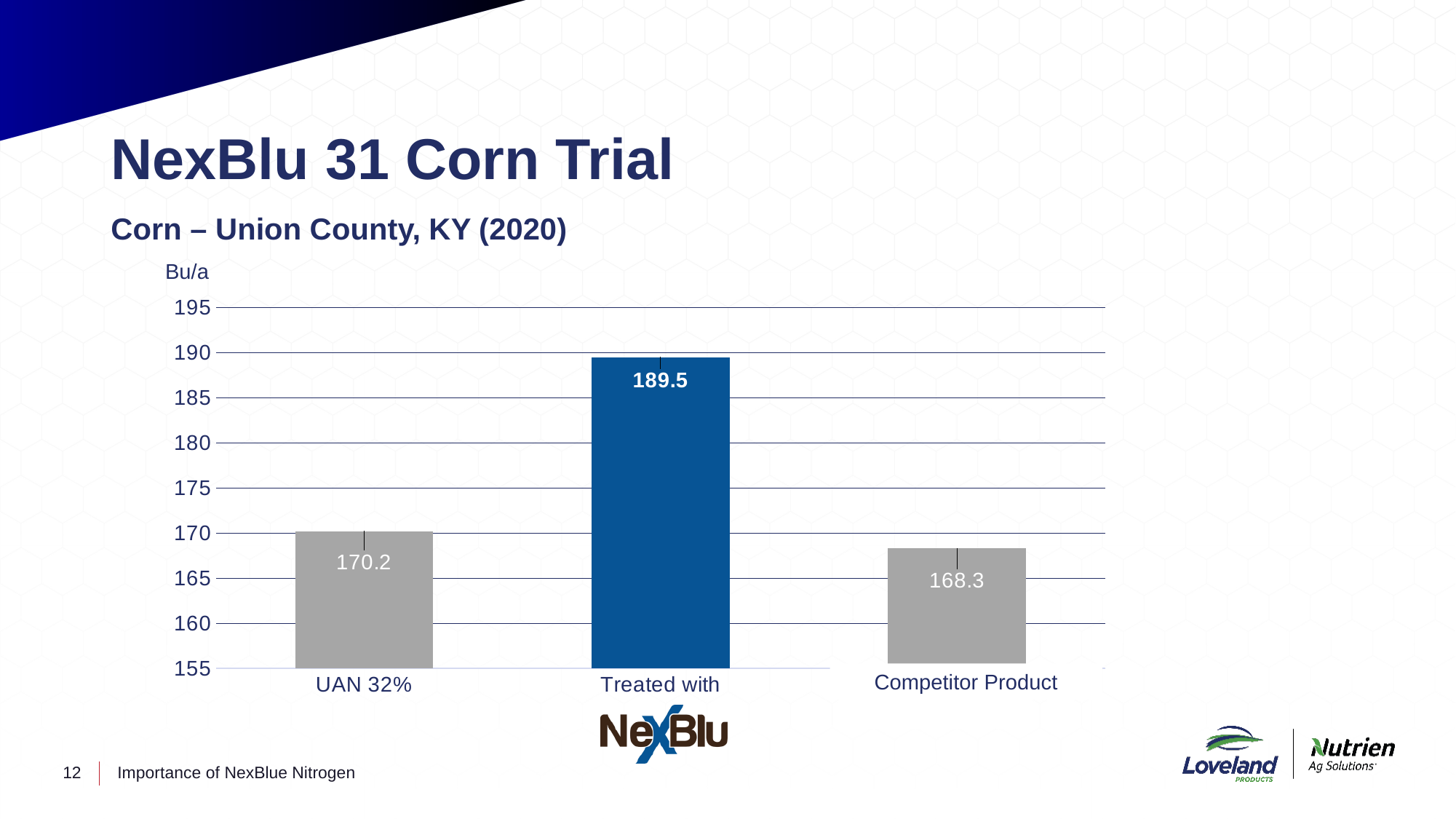
What is the value for Competitor Product? 168.3 What is the difference between the Treated with NexBlu value and the UAN 32% value? 19.3 What kind of chart is shown on the slide? Bar chart What is the value for UAN 32%? 170.2 What is the value for Treated with NexBlu? 189.5 What is the difference between the UAN 32% value and the Competitor Product value? 1.9 Which category has the lowest value? Competitor Product Which category has the highest value? Treated with NexBlu What unit is shown on the y axis of the chart? Bu/a Which is larger, the value for UAN 32% or the value for Competitor Product? UAN 32% Is the value for Treated with NexBlu greater or less than 185? greater How many categories are shown on the chart? 3